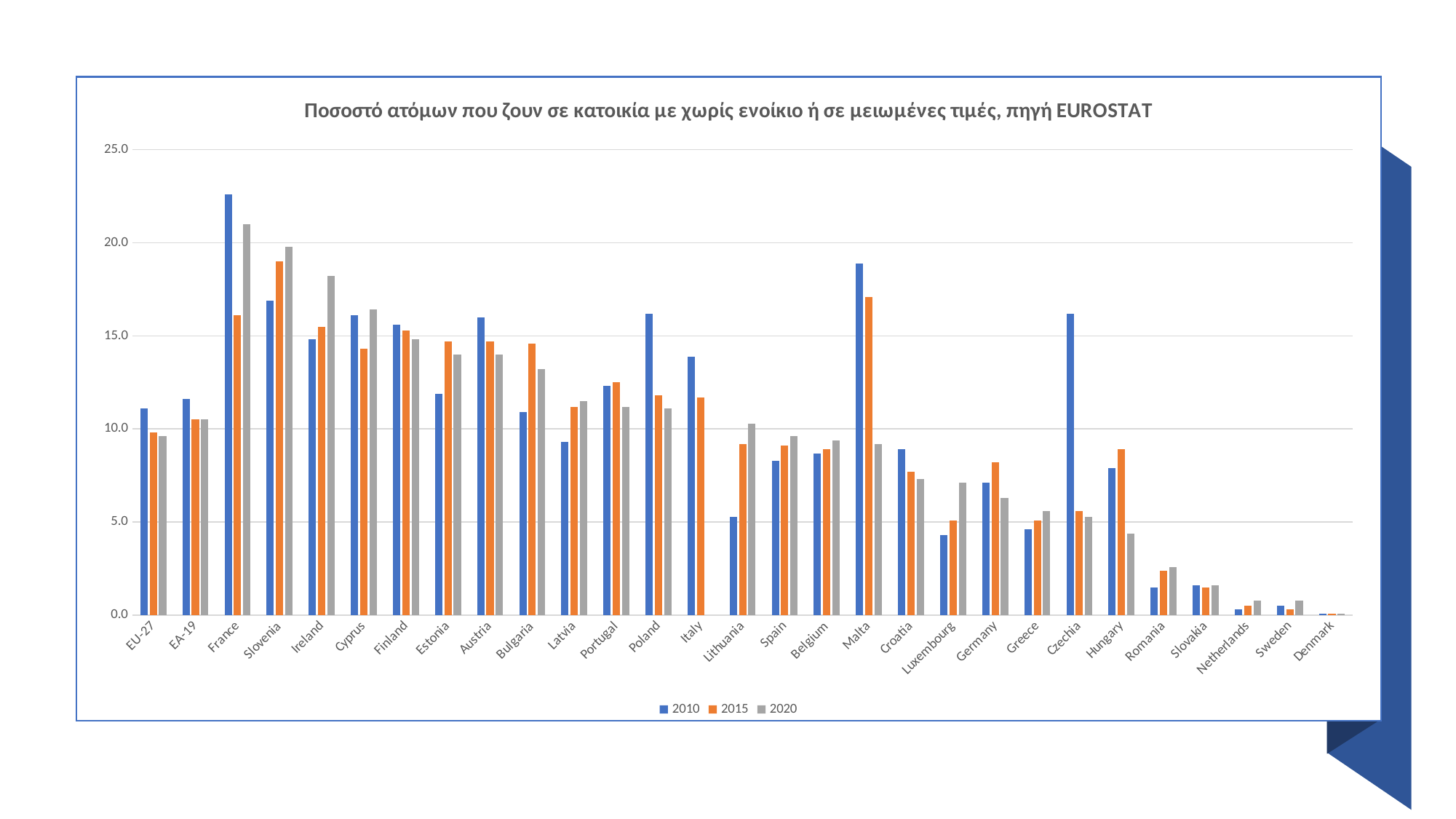
How many categories are shown on the x axis? 29 Which data source is named in the chart title? EUROSTAT Which category has the lowest value for the 2010 series? Denmark Which is larger for Czechia: the 2010 value or the 2020 value? 2010 What kind of chart is shown on the slide? bar chart Which is larger for Lithuania: the 2010 value or the 2020 value? 2020 Is the value for Czechia in 2020 greater or less than 10.0? less How many series does the legend list? 3 Is the value for France in 2010 greater or less than 20.0? greater Which category has the highest value for the 2020 series? France Is the value for Ireland in 2020 greater or less than 15.0? greater Which category has the highest value for the 2010 series? France